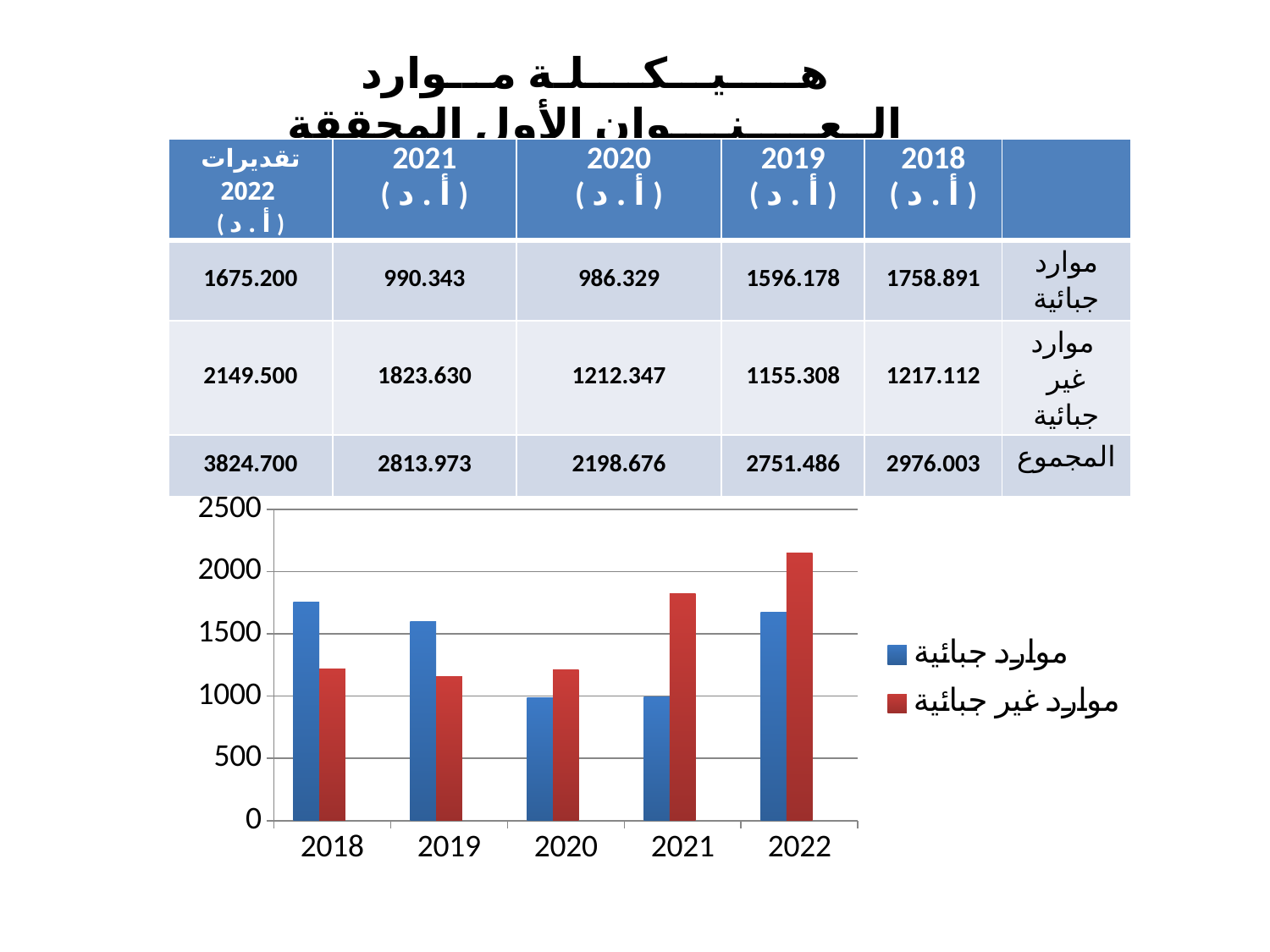
Is the value for موارد جبائية in 2020 greater or less than 1000? less Is the value for موارد غير جبائية in 2022 greater or less than 2000? greater How many years are shown on the x axis of the chart? 5 Do the values for موارد غير جبائية rise or fall from 2020 to 2022? rise Which colour represents موارد غير جبائية in the chart? red Which year has the highest value for موارد جبائية? 2018 Do the values for موارد جبائية rise or fall from 2018 to 2020? fall Which year has the highest value for موارد غير جبائية? 2022 What kind of chart is shown on the slide? bar chart In 2018, which is larger: موارد جبائية or موارد غير جبائية? موارد جبائية In 2021, which is larger: موارد جبائية or موارد غير جبائية? موارد غير جبائية How many series does the chart legend list? 2